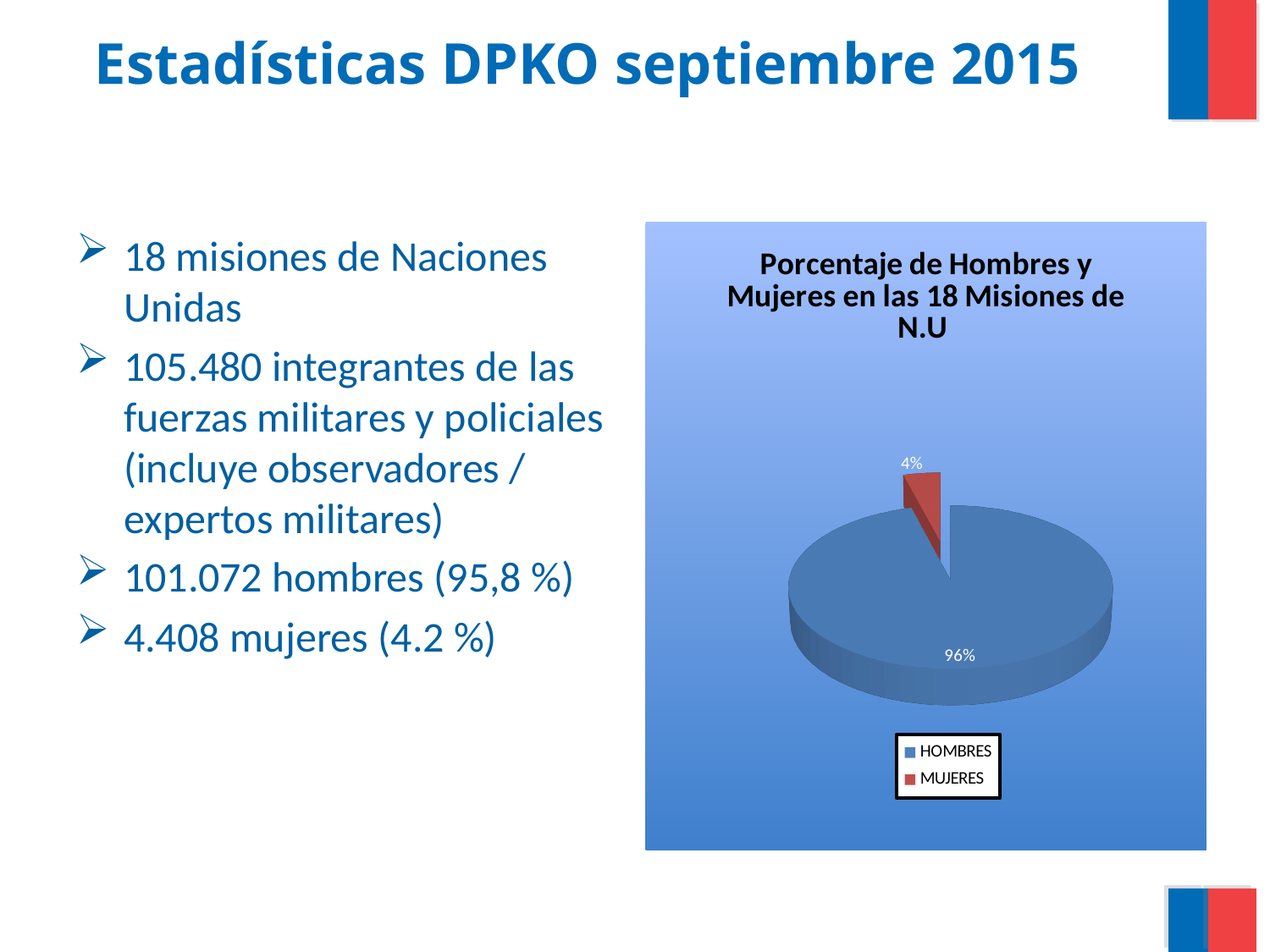
What is the difference in percentage points between the HOMBRES and MUJERES slices? 92 What colour is the MUJERES slice in the pie chart? red What percentage of the pie does HOMBRES represent? 96% Which category has the smallest slice of the pie? MUJERES Which category has the largest slice of the pie? HOMBRES Which slice is larger, HOMBRES or MUJERES? HOMBRES How many slices does the pie chart have? 2 What kind of chart is shown on the slide? pie chart What percentage of the pie does MUJERES represent? 4% How many categories does the legend list? 2 What is the title of the chart? Porcentaje de Hombres y Mujeres en las 18 Misiones de N.U